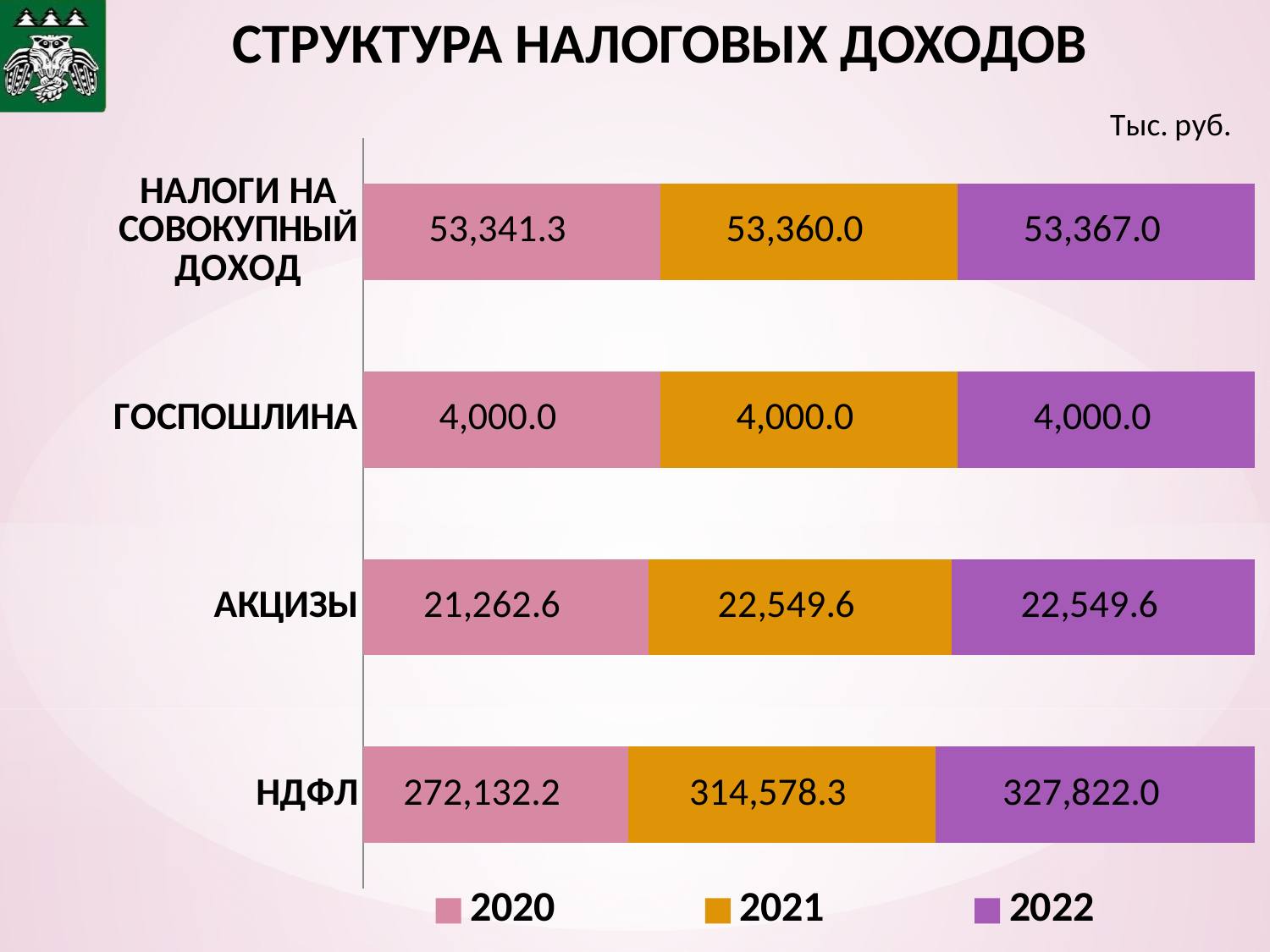
What kind of chart is shown on the slide? Stacked bar chart Which category has the highest value in 2020? НДФЛ How many categories are shown on the chart? 4 Which is larger for АКЦИЗЫ: the 2020 value or the 2021 value? 2021 Which category has the lowest value in 2021? ГОСПОШЛИНА What is the value for АКЦИЗЫ in 2020? 21,262.6 What is the value for НАЛОГИ НА СОВОКУПНЫЙ ДОХОД in 2021? 53,360.0 Do the НДФЛ values rise or fall from 2020 to 2022? Rise What is the value for ГОСПОШЛИНА in 2022? 4,000.0 What is the difference between the НДФЛ values for 2022 and 2020? 55,689.8 What is the value for НДФЛ in 2022? 327,822.0 How many series does the legend list? 3